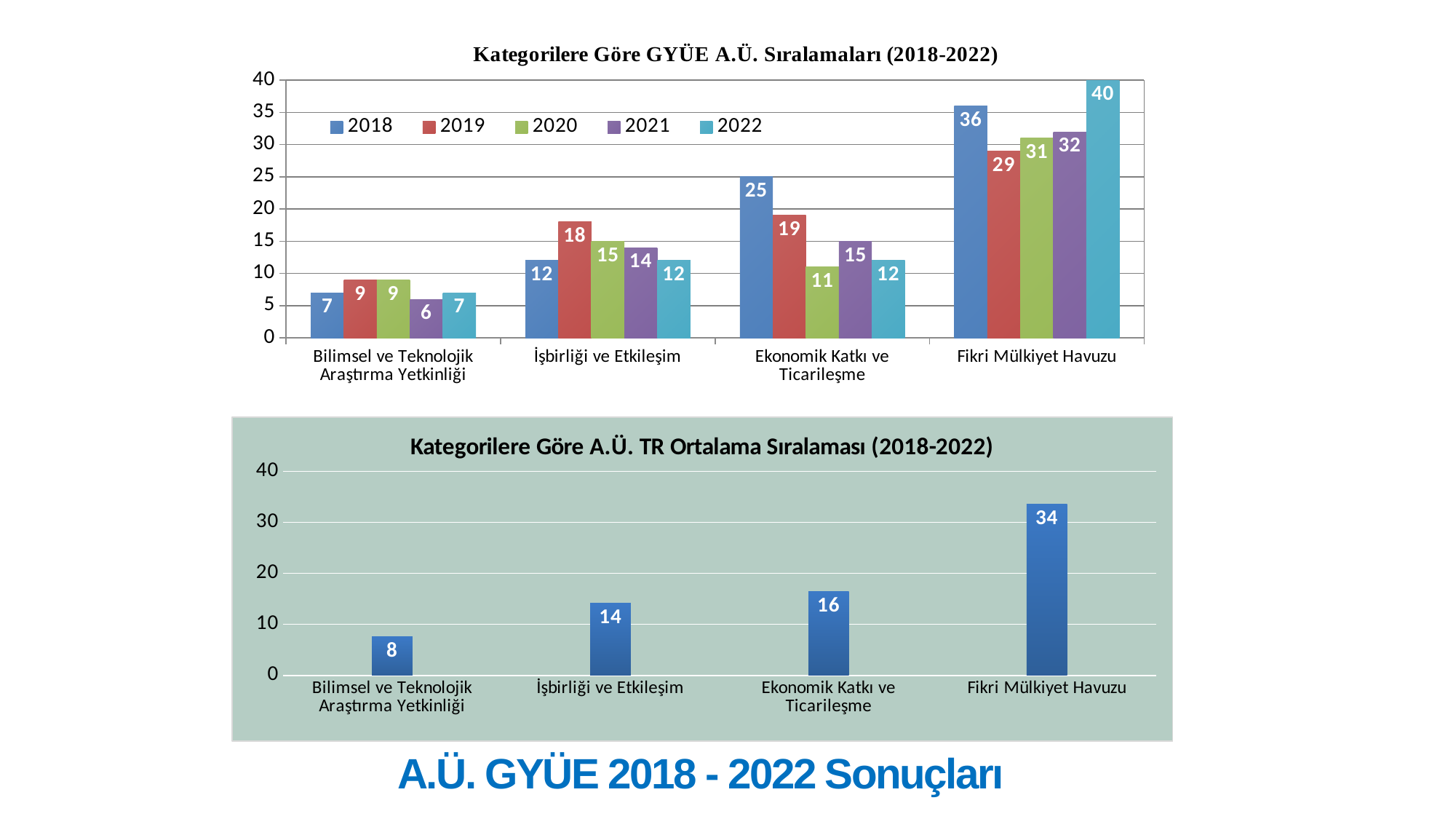
In the bottom chart 'Kategorilere Göre A.Ü. TR Ortalama Sıralaması (2018-2022)', what is the value for İşbirliği ve Etkileşim? 14 In the top chart, which year has the lowest value for Fikri Mülkiyet Havuzu? 2019 What kind of chart is the bottom chart? Bar chart In the top chart 'Kategorilere Göre GYÜE A.Ü. Sıralamaları (2018-2022)', what is the value for Fikri Mülkiyet Havuzu in 2022? 40 In the top chart, what is the difference between the 2018 and 2020 values for Ekonomik Katkı ve Ticarileşme? 14 In the bottom chart, which category has the highest value? Fikri Mülkiyet Havuzu In the top chart, what is the value for Bilimsel ve Teknolojik Araştırma Yetkinliği in 2021? 6 In the top chart, which year has the highest value for İşbirliği ve Etkileşim? 2019 In the top chart, what is the value for Ekonomik Katkı ve Ticarileşme in 2018? 25 In the top chart, how many series does the legend list? 5 In the top chart, is the 2021 value for Fikri Mülkiyet Havuzu greater or less than the 2021 value for Ekonomik Katkı ve Ticarileşme? greater In the bottom chart, what is the difference between Fikri Mülkiyet Havuzu and Bilimsel ve Teknolojik Araştırma Yetkinliği? 26